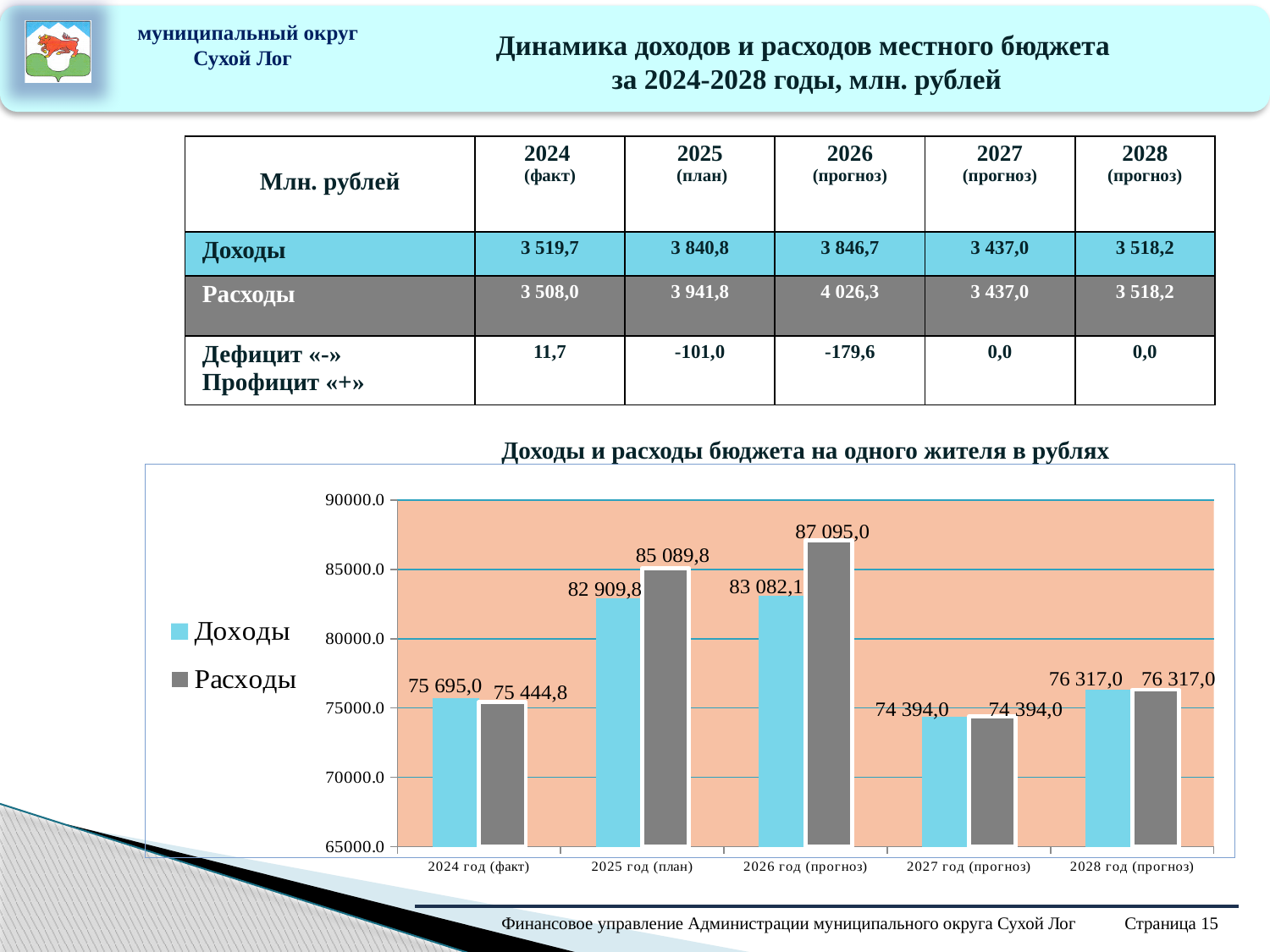
What type of chart is shown? bar chart How many year categories are shown on the x axis? 5 What is the value of Доходы for 2028 год (прогноз)? 76 317,0 What is the value of Расходы for 2026 год (прогноз)? 87 095,0 What is the value of Доходы for 2025 год (план)? 82 909,8 How many series does the legend list? 2 Which is larger for 2025 год (план): Доходы or Расходы? Расходы Which year has the highest Расходы value? 2026 год (прогноз) What is the value of Расходы for 2024 год (факт)? 75 444,8 Which year has the lowest Доходы value? 2027 год (прогноз) What is the difference between Расходы and Доходы for 2026 год (прогноз)? 4 012,9 Is the value of Доходы for 2027 год (прогноз) greater or less than 75000.0? less